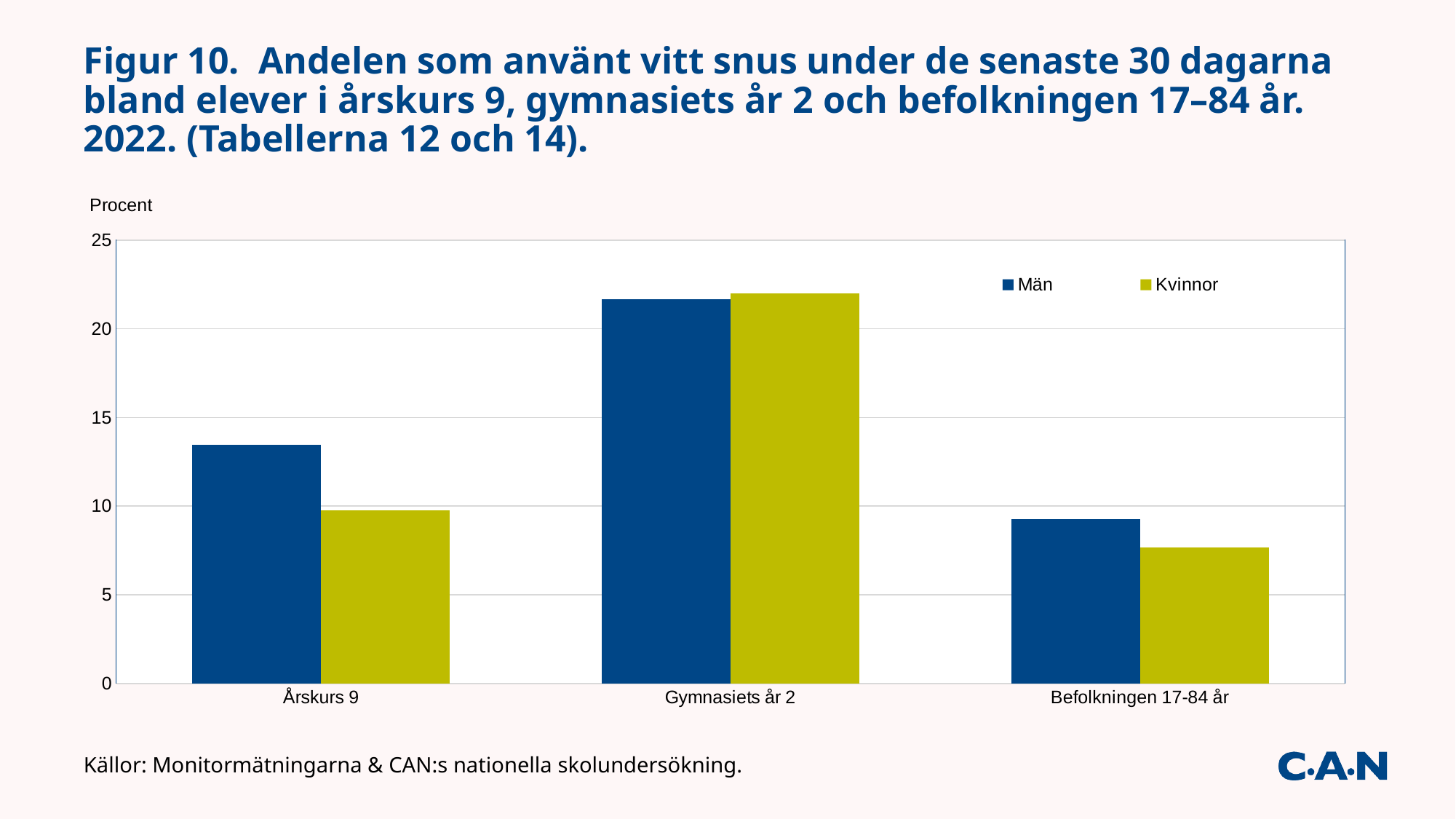
Is the Män value for Årskurs 9 greater or less than 10? greater Which series are listed in the legend? Män and Kvinnor For which category is the Män value lowest? Befolkningen 17-84 år For which category is the Kvinnor value highest? Gymnasiets år 2 For which category is the Kvinnor value lowest? Befolkningen 17-84 år How many categories are shown on the x axis? 3 For which category is the Män value highest? Gymnasiets år 2 For Årskurs 9, which is larger, the Män value or the Kvinnor value? Män What is the label on the y axis? Procent Is the Kvinnor value for Befolkningen 17-84 år greater or less than 10? less What kind of chart is shown on the slide? bar chart How many series does the legend list? 2